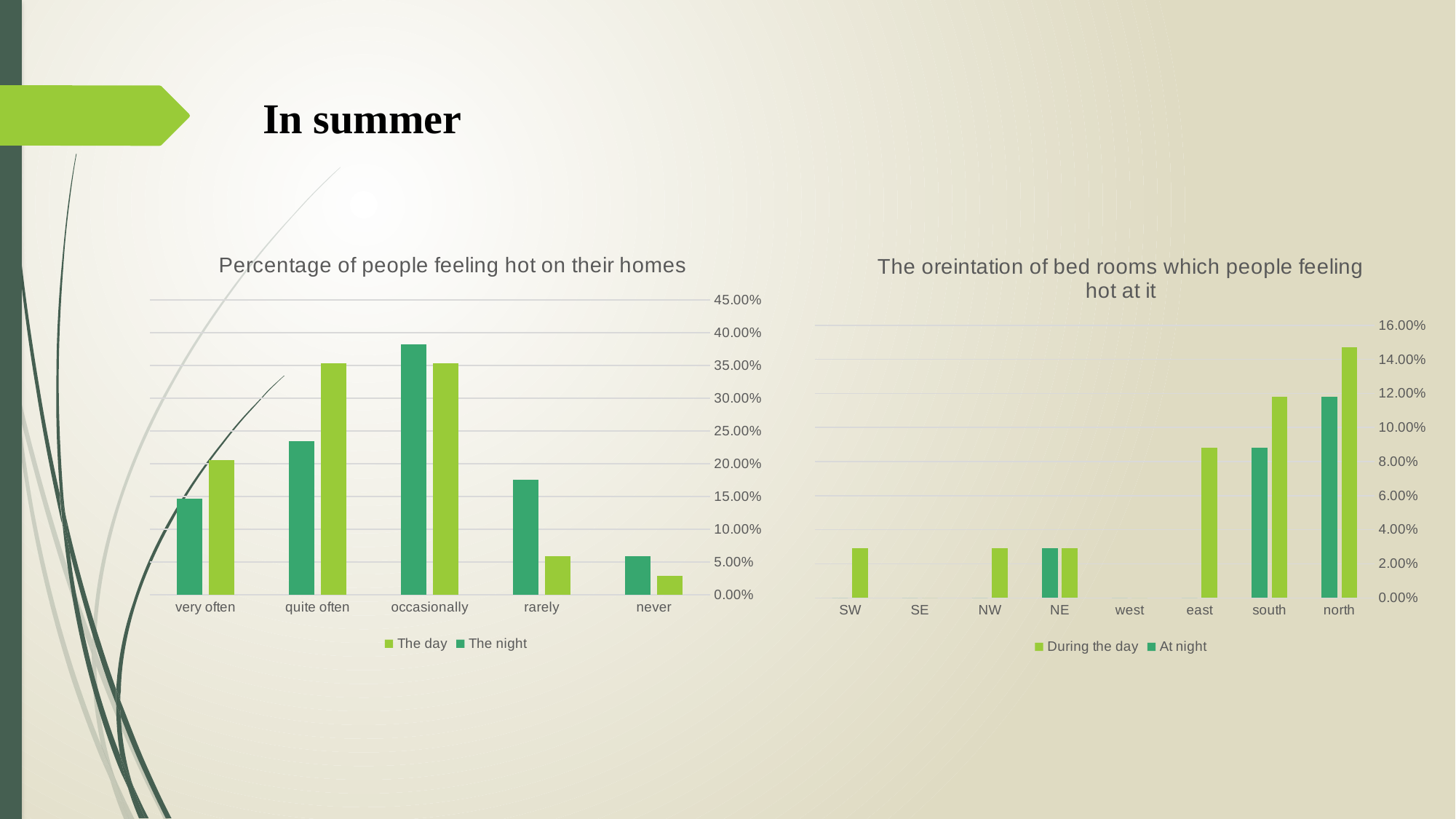
In the 'The oreintation of bed rooms which people feeling hot at it' chart, for 'south', which is larger: 'During the day' or 'At night'? During the day How many orientation categories are shown on the x axis of the 'The oreintation of bed rooms which people feeling hot at it' chart? 8 In the 'Percentage of people feeling hot on their homes' chart, which category has the highest value for 'The night'? occasionally What are the two legend entries of the 'The oreintation of bed rooms which people feeling hot at it' chart? During the day, At night In the 'Percentage of people feeling hot on their homes' chart, for 'very often', which is larger: 'The day' or 'The night'? The day In the 'The oreintation of bed rooms which people feeling hot at it' chart, is the value of 'During the day' for 'east' greater or less than 10.00%? less How many series does the legend of the 'Percentage of people feeling hot on their homes' chart list? 2 How many categories are shown on the x axis of the 'Percentage of people feeling hot on their homes' chart? 5 In the 'The oreintation of bed rooms which people feeling hot at it' chart, which orientation has the highest value for 'During the day'? north In the 'Percentage of people feeling hot on their homes' chart, which category has the lowest value for 'The day'? never What kind of chart is the 'Percentage of people feeling hot on their homes' chart? bar chart In the 'Percentage of people feeling hot on their homes' chart, is the value of 'The day' for 'quite often' greater or less than 30.00%? greater